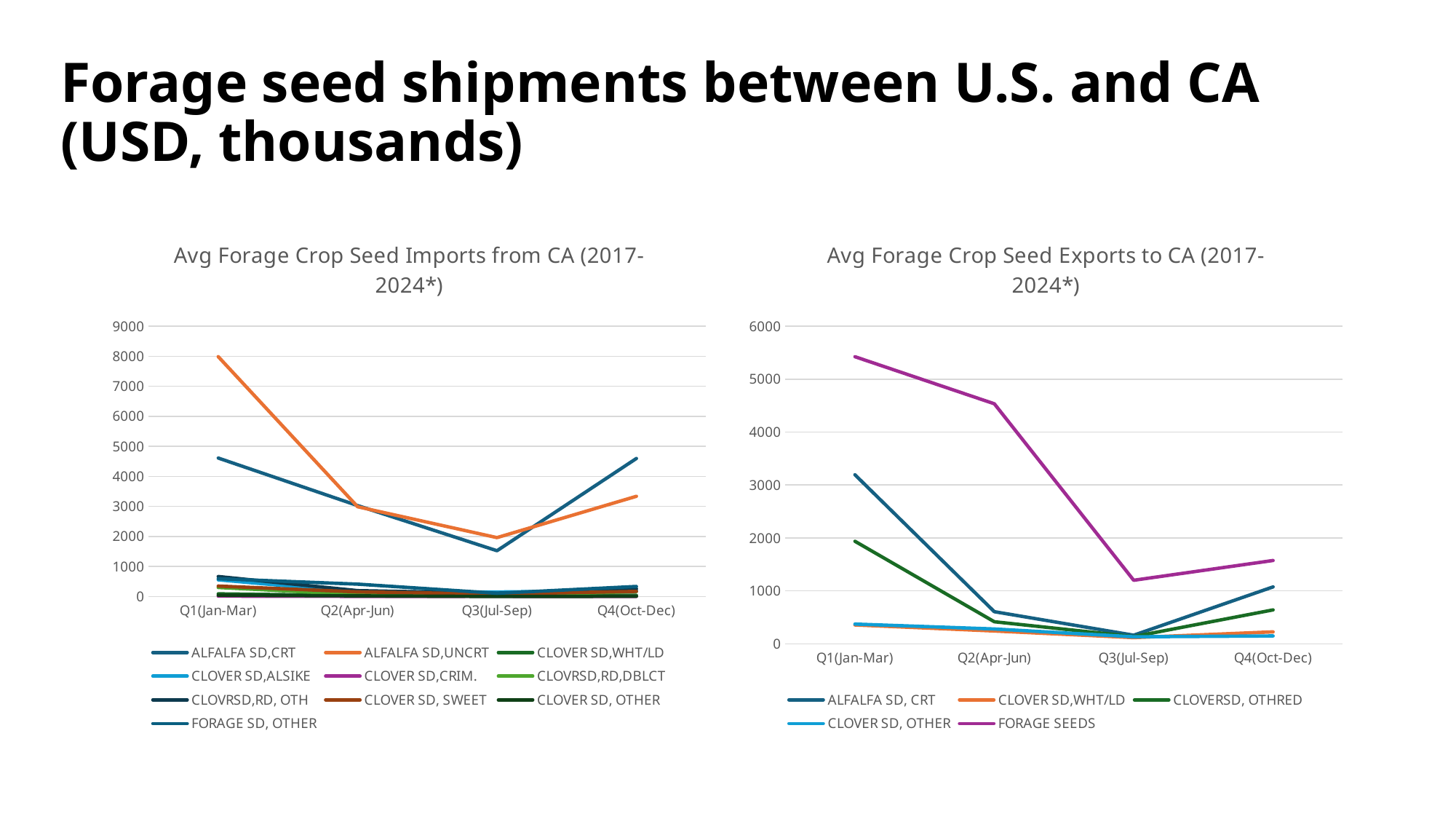
In the 'Avg Forage Crop Seed Exports to CA (2017-2024*)' chart, is the value for FORAGE SEEDS at Q1(Jan-Mar) greater or less than 5000? greater In the 'Avg Forage Crop Seed Exports to CA (2017-2024*)' chart, which series has the highest value at Q1(Jan-Mar)? FORAGE SEEDS How many quarters are shown on the x axis of the 'Avg Forage Crop Seed Exports to CA (2017-2024*)' chart? 4 How many series does the legend of the 'Avg Forage Crop Seed Imports from CA (2017-2024*)' chart list? 10 In the 'Avg Forage Crop Seed Imports from CA (2017-2024*)' chart, is the value for ALFALFA SD,CRT at Q3(Jul-Sep) greater or less than 2000? less In the 'Avg Forage Crop Seed Imports from CA (2017-2024*)' chart, is the value for ALFALFA SD,UNCRT at Q1(Jan-Mar) greater or less than 7000? greater How many series does the legend of the 'Avg Forage Crop Seed Exports to CA (2017-2024*)' chart list? 5 What kind of chart is the 'Avg Forage Crop Seed Imports from CA (2017-2024*)' chart? line chart In the 'Avg Forage Crop Seed Imports from CA (2017-2024*)' chart, which series has the highest value at Q1(Jan-Mar)? ALFALFA SD,UNCRT In the 'Avg Forage Crop Seed Imports from CA (2017-2024*)' chart, does the ALFALFA SD,UNCRT line rise or fall from Q1(Jan-Mar) to Q3(Jul-Sep)? fall In the 'Avg Forage Crop Seed Exports to CA (2017-2024*)' chart, which is larger at Q2(Apr-Jun): FORAGE SEEDS or ALFALFA SD, CRT? FORAGE SEEDS In the 'Avg Forage Crop Seed Exports to CA (2017-2024*)' chart, at which quarter does the FORAGE SEEDS line reach its lowest value? Q3(Jul-Sep)